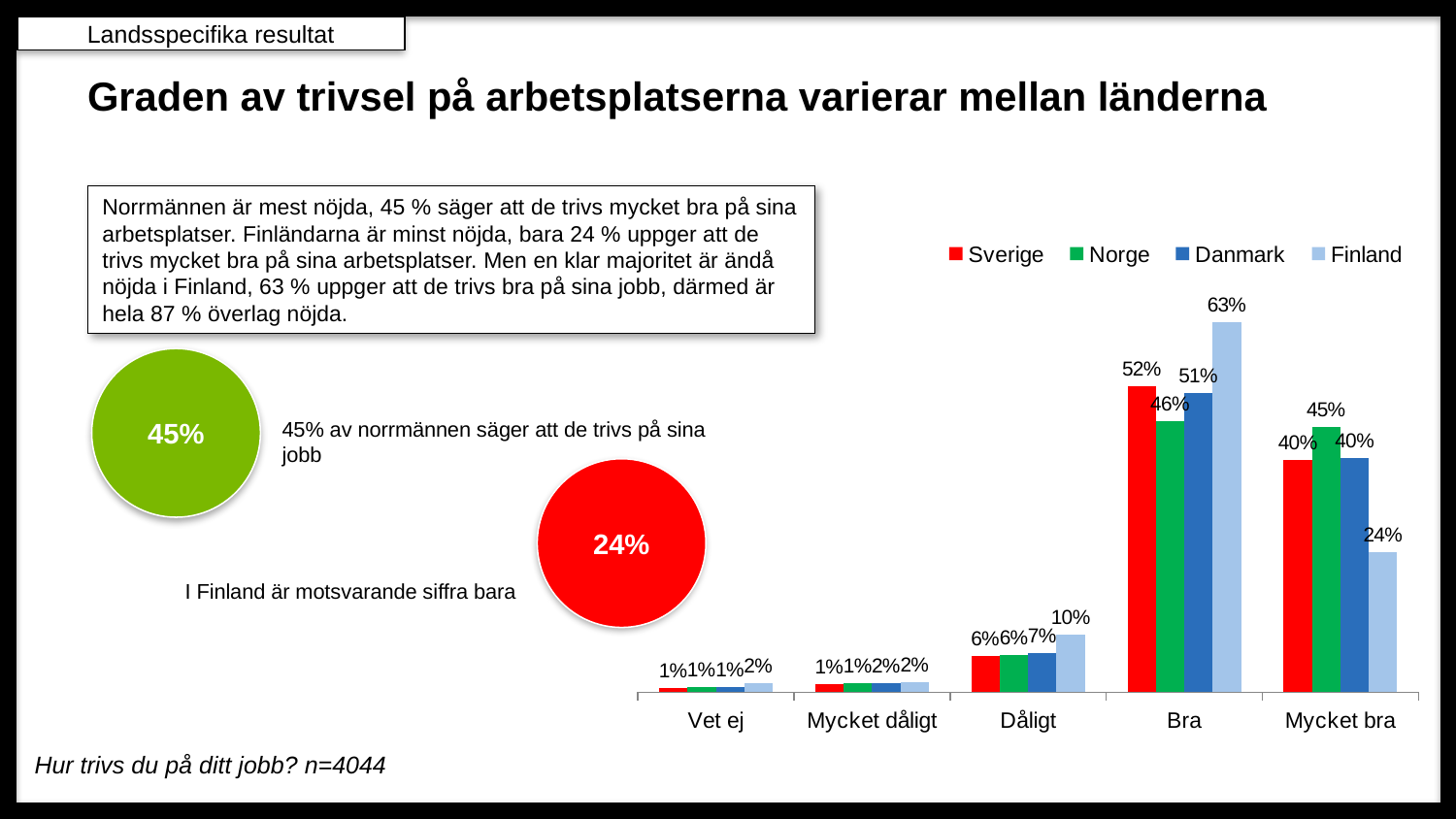
How many series does the chart legend list? 4 What kind of chart is shown on the slide? Bar chart Which country has the highest value in the Bra category? Finland What is the value for Finland in the Bra category? 63% How many categories are shown on the x axis of the chart? 5 Which is larger: Sverige's value in Bra or Danmark's value in Bra? Sverige What is the difference between Finland's and Norge's values in the Bra category? 17% What is the value for Norge in the Mycket bra category? 45% Which colour represents Norge in the chart? Green What is the value for Sverige in the Bra category? 52% What is the value for Finland in the Dåligt category? 10% Which country has the lowest value in the Mycket bra category? Finland